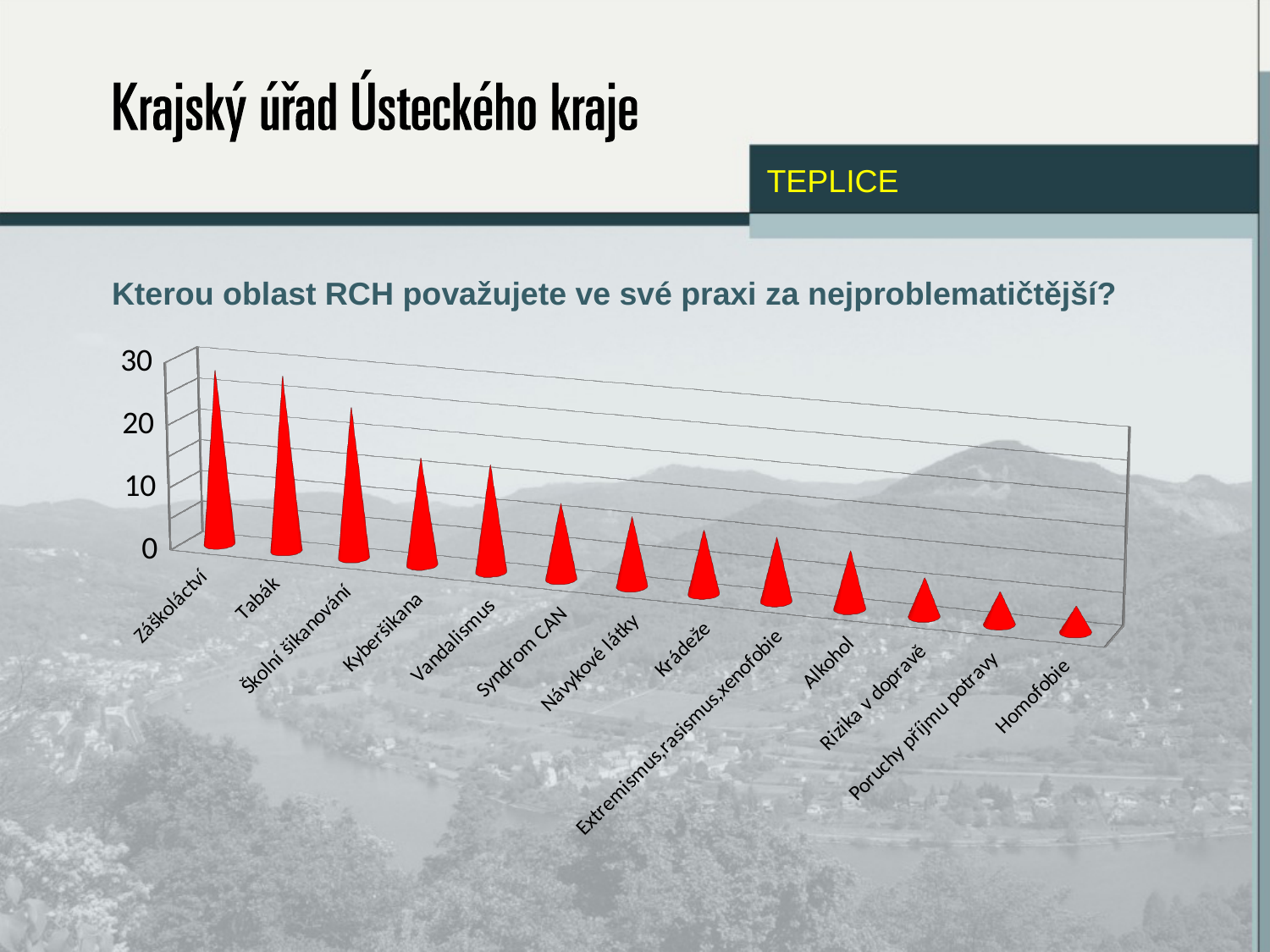
Which category has the lowest value in the chart? Homofobie Do the values rise or fall moving from left to right along the x axis? fall What kind of chart is shown on the slide? bar chart Is the value for Záškoláctví greater or less than 20? greater Is the value for Kyberšikana greater or less than 10? greater Which has a larger value, Krádeže or Tabák? Tabák What question is the chart titled with? Kterou oblast RCH považujete ve své praxi za nejproblematičtější? Is the value for Homofobie greater or less than 10? less Which has a larger value, Kyberšikana or Alkohol? Kyberšikana How many categories are shown on the x axis of the chart? 13